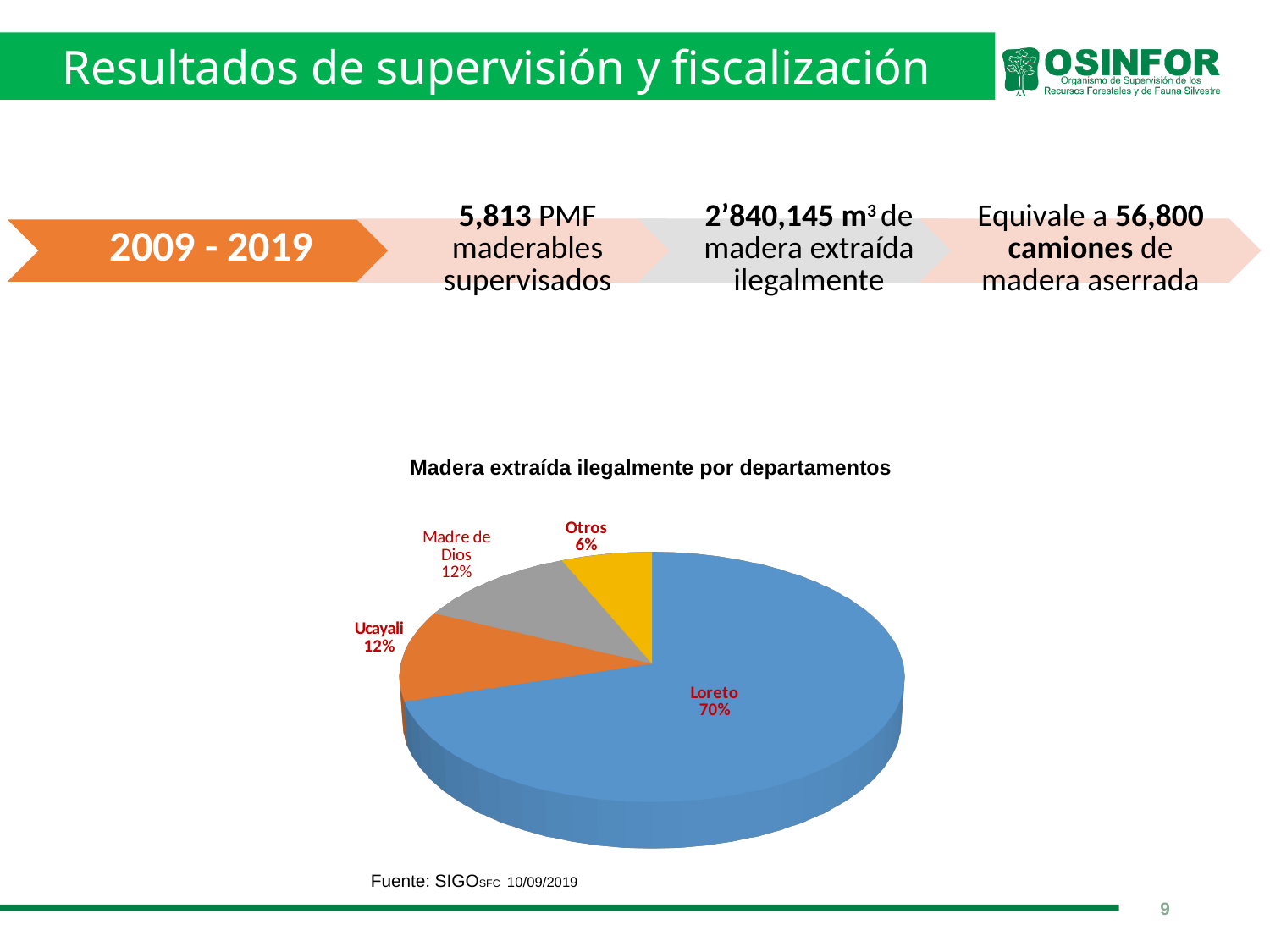
Which department has the largest slice of the pie? Loreto Which category has the smallest slice of the pie? Otros What is the value shown for Madre de Dios? 12% What kind of chart is shown on the slide? Pie chart What is the value shown for Otros? 6% Which is larger, the slice for Ucayali or the slice for Otros? Ucayali What is the value shown for Ucayali? 12% How many slices does the pie chart have? 4 What is the title of the chart? Madera extraída ilegalmente por departamentos What is the difference in percentage points between Loreto and Ucayali? 58 What share of the pie does Loreto represent? 70% What is the difference in percentage points between Madre de Dios and Otros? 6